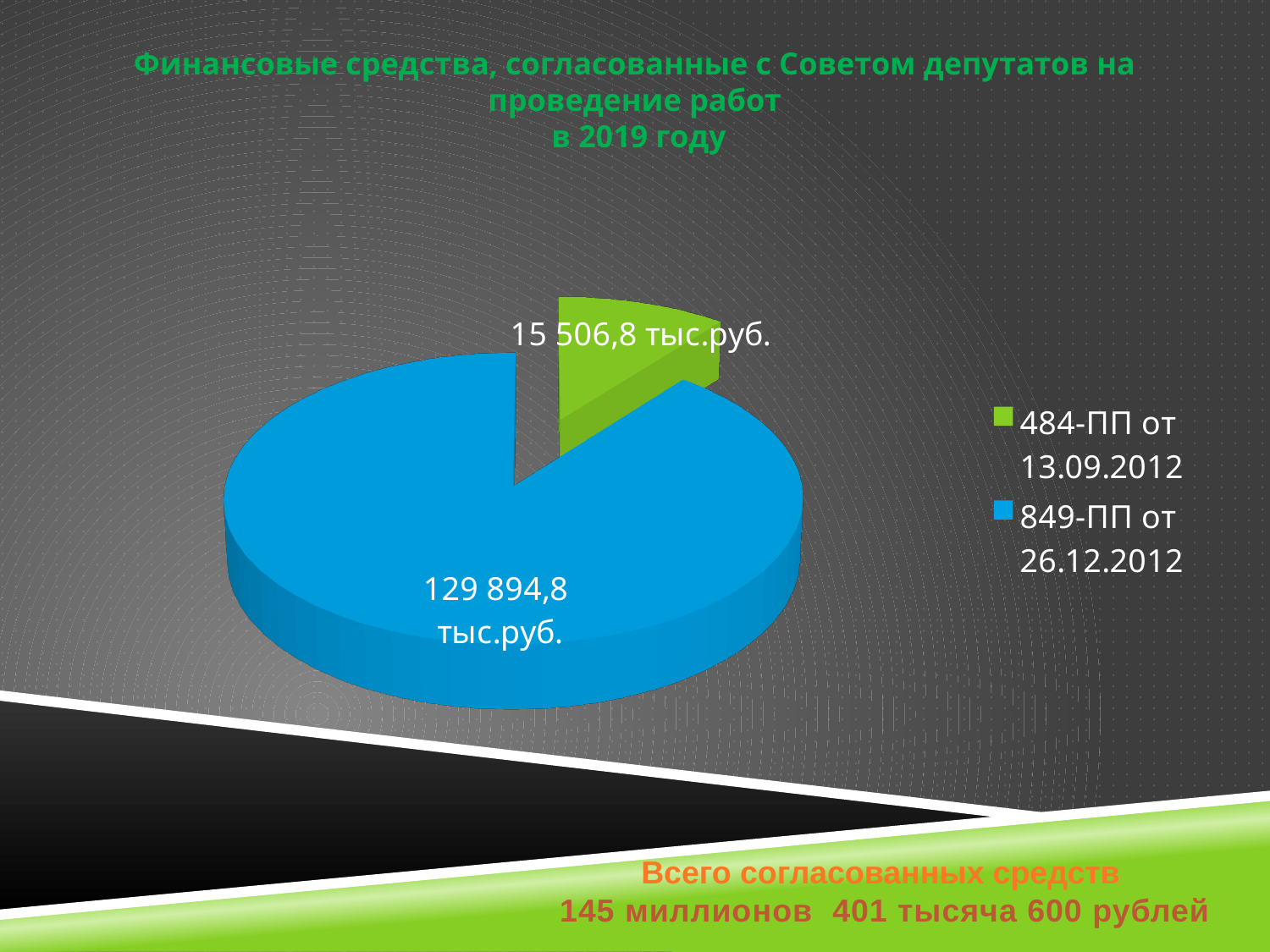
Which is larger: the value for 484-ПП от 13.09.2012 or the value for 849-ПП от 26.12.2012? 849-ПП от 26.12.2012 How many slices does the pie chart have? 2 How many entries does the legend list? 2 What is the total of the two slices in the pie chart? 145 401,6 тыс.руб. Which category has the smallest slice of the pie? 484-ПП от 13.09.2012 What kind of chart is shown on the slide? Pie chart What is the difference between the value for 849-ПП от 26.12.2012 and the value for 484-ПП от 13.09.2012? 114 388 тыс.руб. What is the value of the slice for 849-ПП от 26.12.2012? 129 894,8 тыс.руб. What colour is the slice for 484-ПП от 13.09.2012? Green Which category has the largest slice of the pie? 849-ПП от 26.12.2012 What is the value of the slice for 484-ПП от 13.09.2012? 15 506,8 тыс.руб. What colour is the slice for 849-ПП от 26.12.2012? Blue